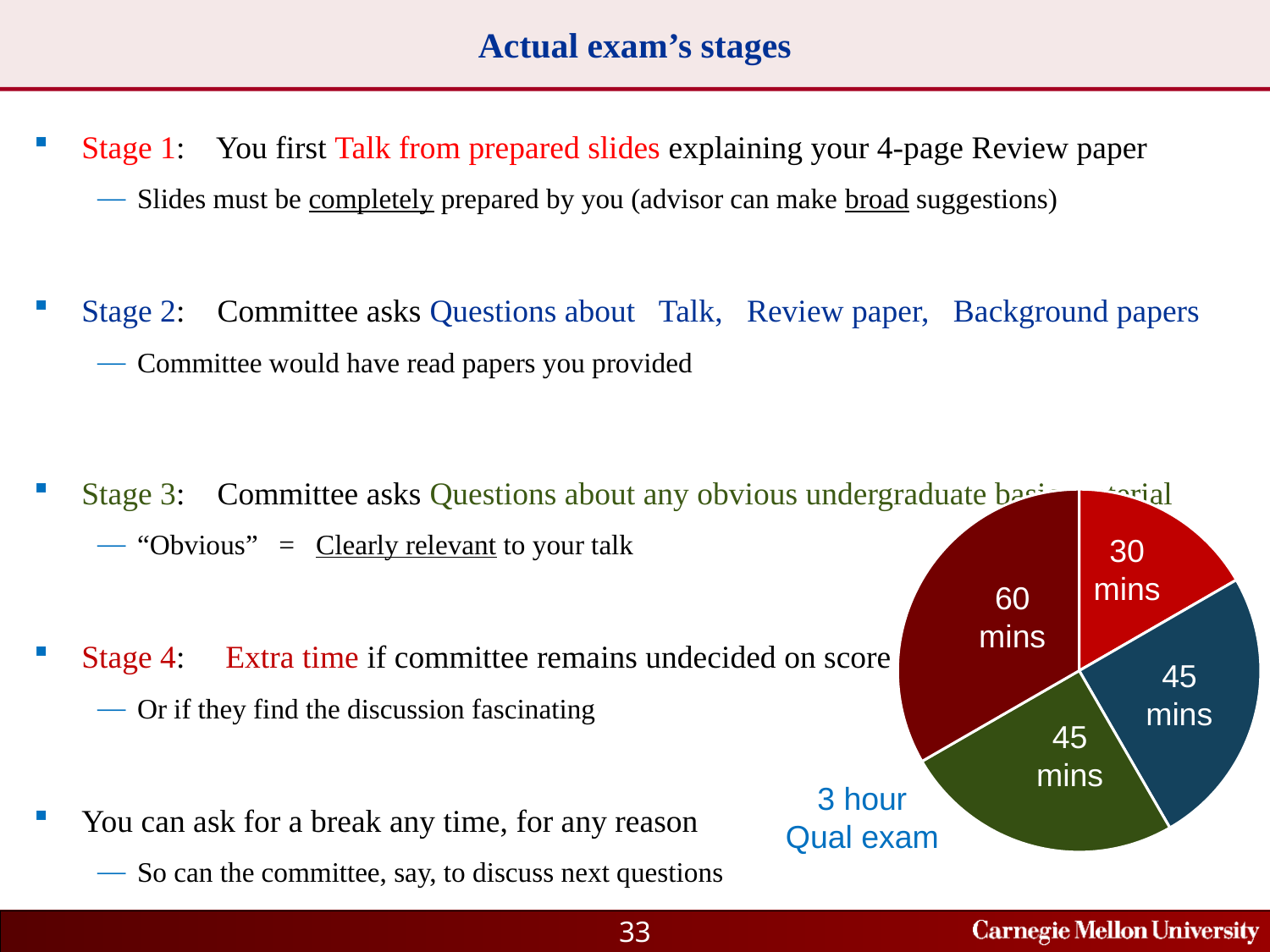
How many slices in the pie chart are labelled 45 mins? 2 Which is larger in the pie chart, the bright red slice or the dark red slice? the dark red slice (60 mins) What kind of chart is shown on the slide? pie chart How many slices does the pie chart have? 4 What label is written next to the pie chart describing what it represents? 3 hour Qual exam What colour is the 60 mins slice of the pie chart? dark red What is the difference between the largest slice (60 mins) and the smallest slice (30 mins) in the pie chart? 30 mins What is the value of the smallest slice in the pie chart? 30 mins What is the total of all the slices in the pie chart? 180 mins What is the value of the largest slice in the pie chart? 60 mins What share of the pie does the 60 mins slice represent? one third (33.3%)